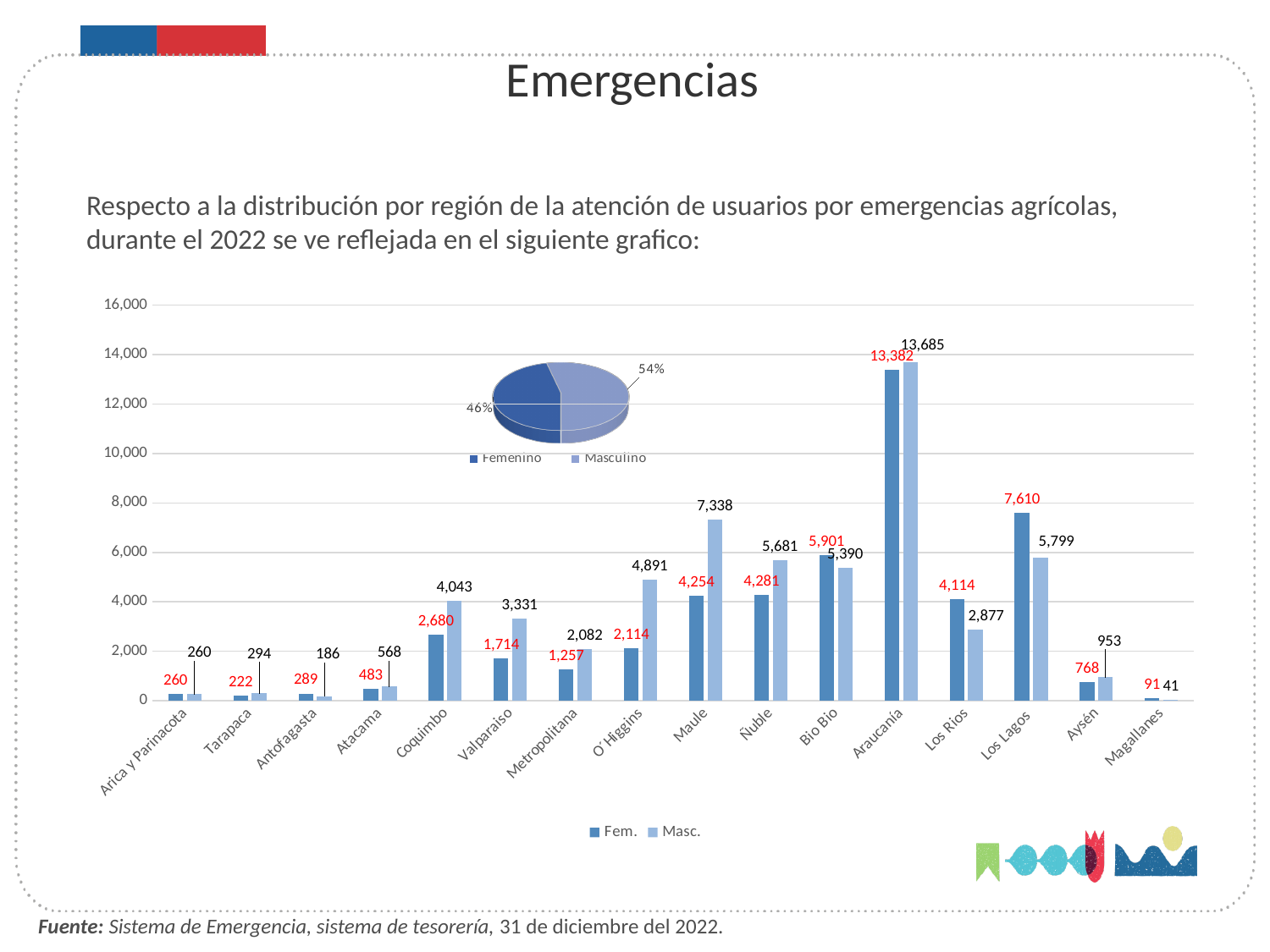
In the bar chart, what is the Masc. value for Maule? 7,338 In the bar chart, what is the Fem. value for Los Lagos? 7,610 In the bar chart, which is larger for Bio Bio, the Fem. value or the Masc. value? Fem. In the bar chart, what is the difference between the Fem. and Masc. values for Los Rios? 1,237 In the bar chart, what is the Fem. value for Coquimbo? 2,680 How many series does the legend of the bar chart list? 2 In the bar chart, what is the difference between the Masc. and Fem. values for O'Higgins? 2,777 In the bar chart, which region has the highest Masc. value? Araucanía How many regions are shown on the x axis of the bar chart? 16 In the bar chart, which region has the lowest Fem. value? Magallanes What kind of chart is the large chart on the slide? Bar chart In the pie chart, what share is labelled for Masculino? 54%